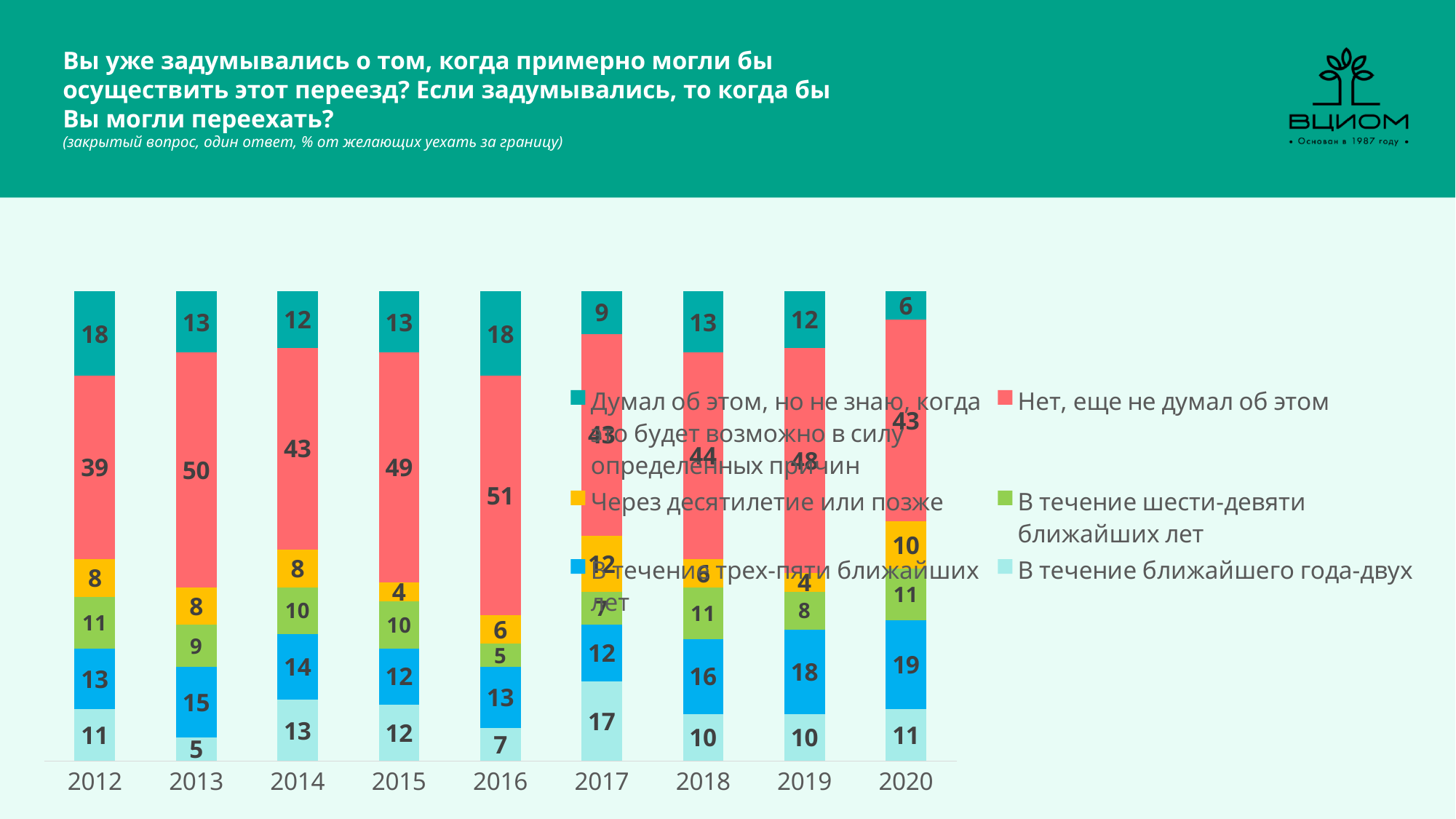
What is the difference between the values for "В течение трех-пяти ближайших лет" in 2020 and in 2012? 6 How many series does the chart's legend list? 6 What kind of chart is shown on the slide? Stacked bar chart In which year is the value for "Нет, еще не думал об этом" the highest? 2016 Does the value for "В течение трех-пяти ближайших лет" rise or fall from 2018 to 2020? Rise Which is larger: the value for "Через десятилетие или позже" in 2014 or in 2015? 2014 What is the value for "Нет, еще не думал об этом" in 2016? 51 What is the total of the stacked bar for 2012? 100 In which year is the value for "Думал об этом, но не знаю, когда это будет возможно в силу определенных причин" the lowest? 2020 What is the value for "В течение трех-пяти ближайших лет" in 2020? 19 What is the value for "В течение ближайшего года-двух" in 2013? 5 How many years are shown along the x axis of the chart? 9